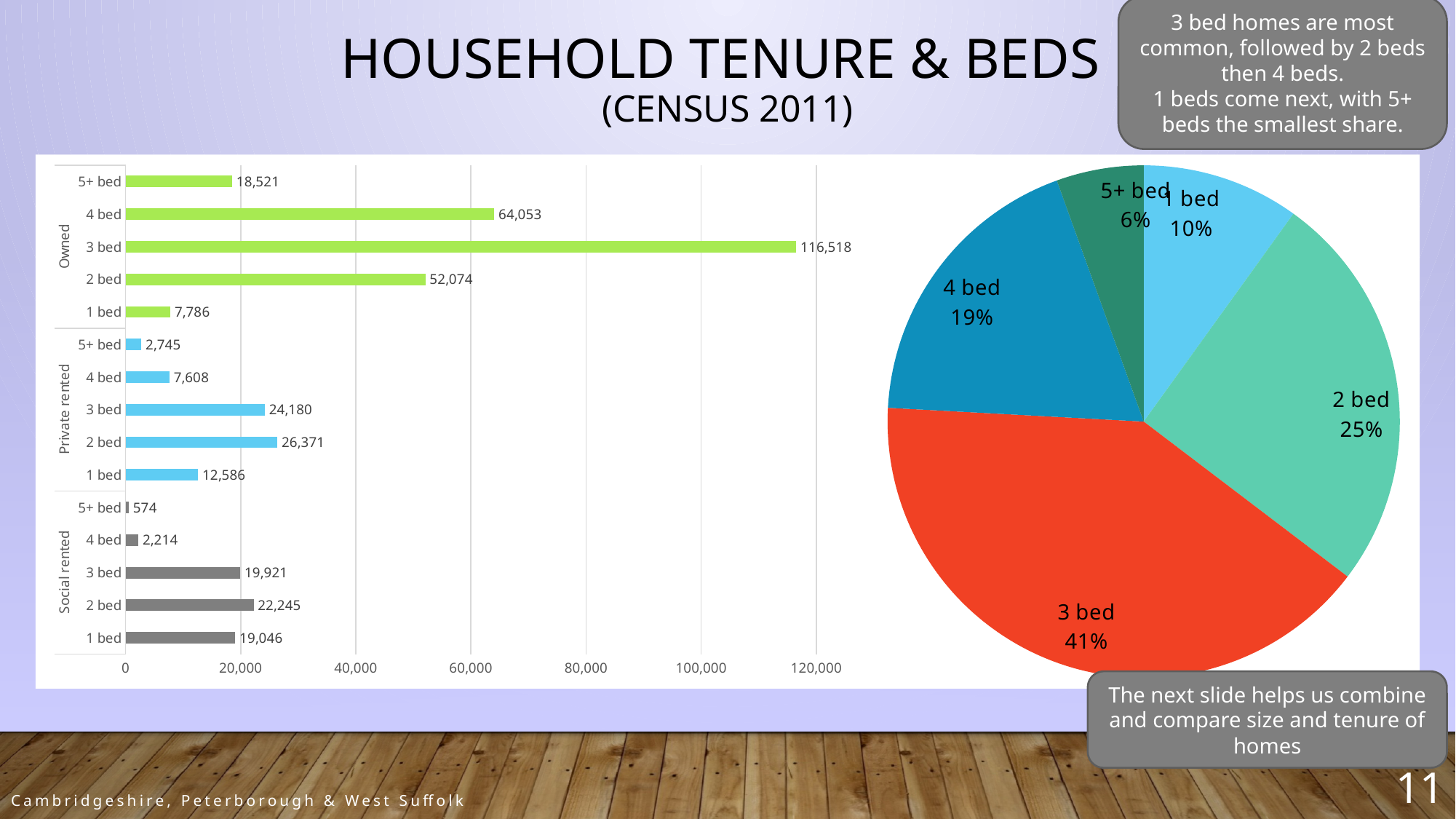
In the pie chart on the right, which slice is the smallest? 5+ bed In the pie chart on the right, how many slices are there? 5 What kind of chart is shown on the left of the slide? Bar chart In the bar chart on the left, which bar has the highest value? Owned 3 bed In the bar chart on the left, which is larger: Private rented 2 bed or Social rented 2 bed? Private rented 2 bed In the bar chart on the left, what is the value for 5+ bed homes in the Social rented group? 574 In the bar chart on the left, what is the value for 3 bed homes in the Owned group? 116,518 In the bar chart on the left, which bar has the lowest value? Social rented 5+ bed In the bar chart on the left, what is the value for 1 bed homes in the Private rented group? 12,586 In the pie chart on the right, what share do 3 bed homes have? 41% In the bar chart on the left, what is the difference between Owned 4 bed and Owned 2 bed? 11,979 In the bar chart on the left, how many bars are plotted in total? 15